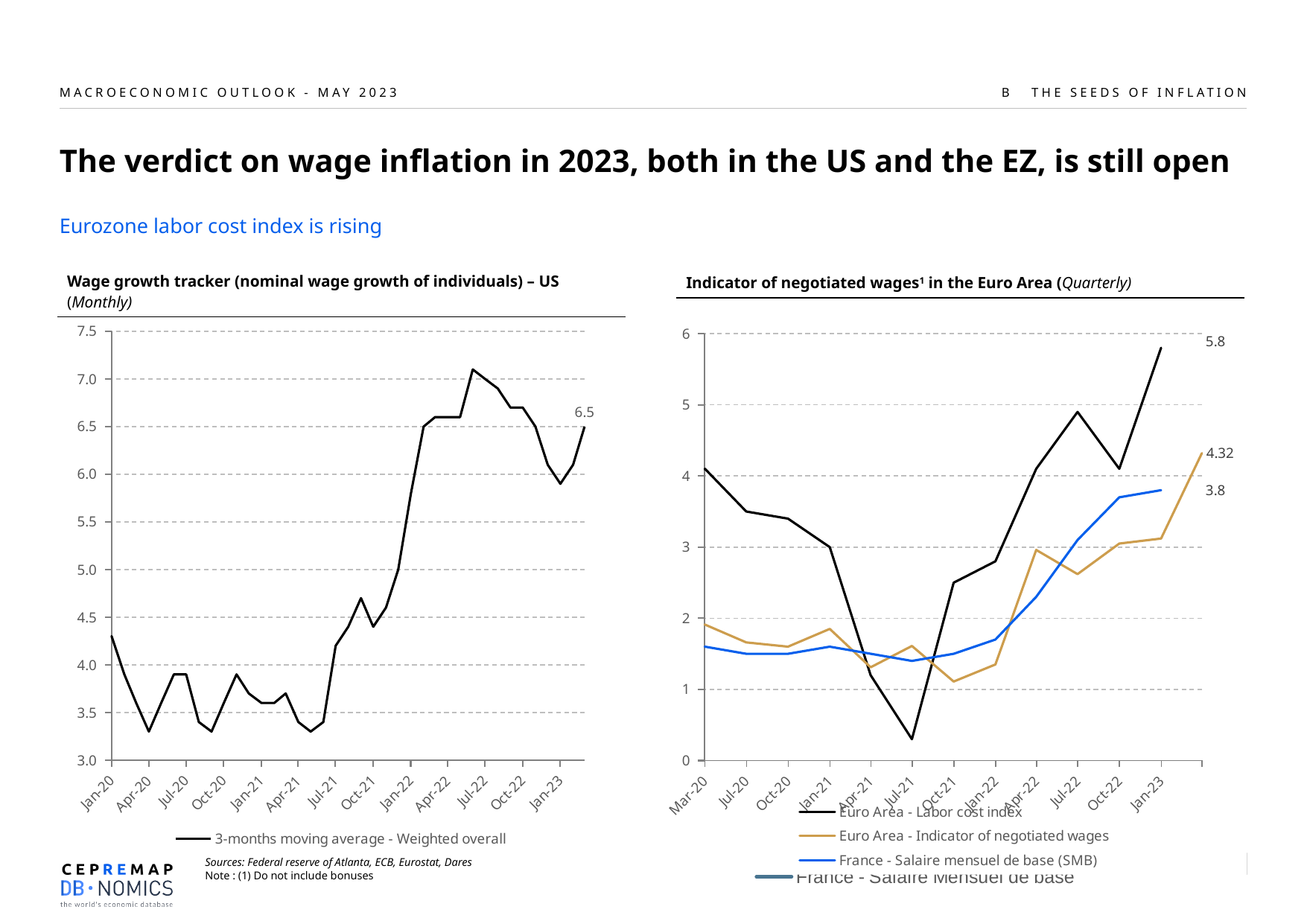
In the left chart (US wage growth tracker), is the value at Jan-20 greater or less than 4.0? greater What kind of chart is the left chart, 'Wage growth tracker (nominal wage growth of individuals) – US'? line chart In the right chart (Indicator of negotiated wages in the Euro Area), what is the final value printed for the Euro Area - Indicator of negotiated wages? 4.32 In the right chart (Indicator of negotiated wages in the Euro Area), what is the difference between the final labeled values of the Euro Area - Labor cost index and the Euro Area - Indicator of negotiated wages? 1.48 In the right chart (Indicator of negotiated wages in the Euro Area), is the Euro Area - Labor cost index at Jul-21 greater or less than 1? less In the right chart (Indicator of negotiated wages in the Euro Area), which series has the highest final labeled value? Euro Area - Labor cost index In the right chart (Indicator of negotiated wages in the Euro Area), does the France - Salaire mensuel de base (SMB) line rise or fall from Jan-22 to Jan-23? rise In the right chart (Indicator of negotiated wages in the Euro Area), what is the final value printed for France - Salaire mensuel de base (SMB)? 3.8 In the left chart (US wage growth tracker), is the value at Apr-22 greater or less than 6.0? greater In the right chart (Indicator of negotiated wages in the Euro Area), what is the final value printed for the Euro Area - Labor cost index? 5.8 In the left chart (US wage growth tracker), what is the series name shown in the legend? 3-months moving average - Weighted overall In the left chart (US wage growth tracker), what is the value printed at the end of the line? 6.5